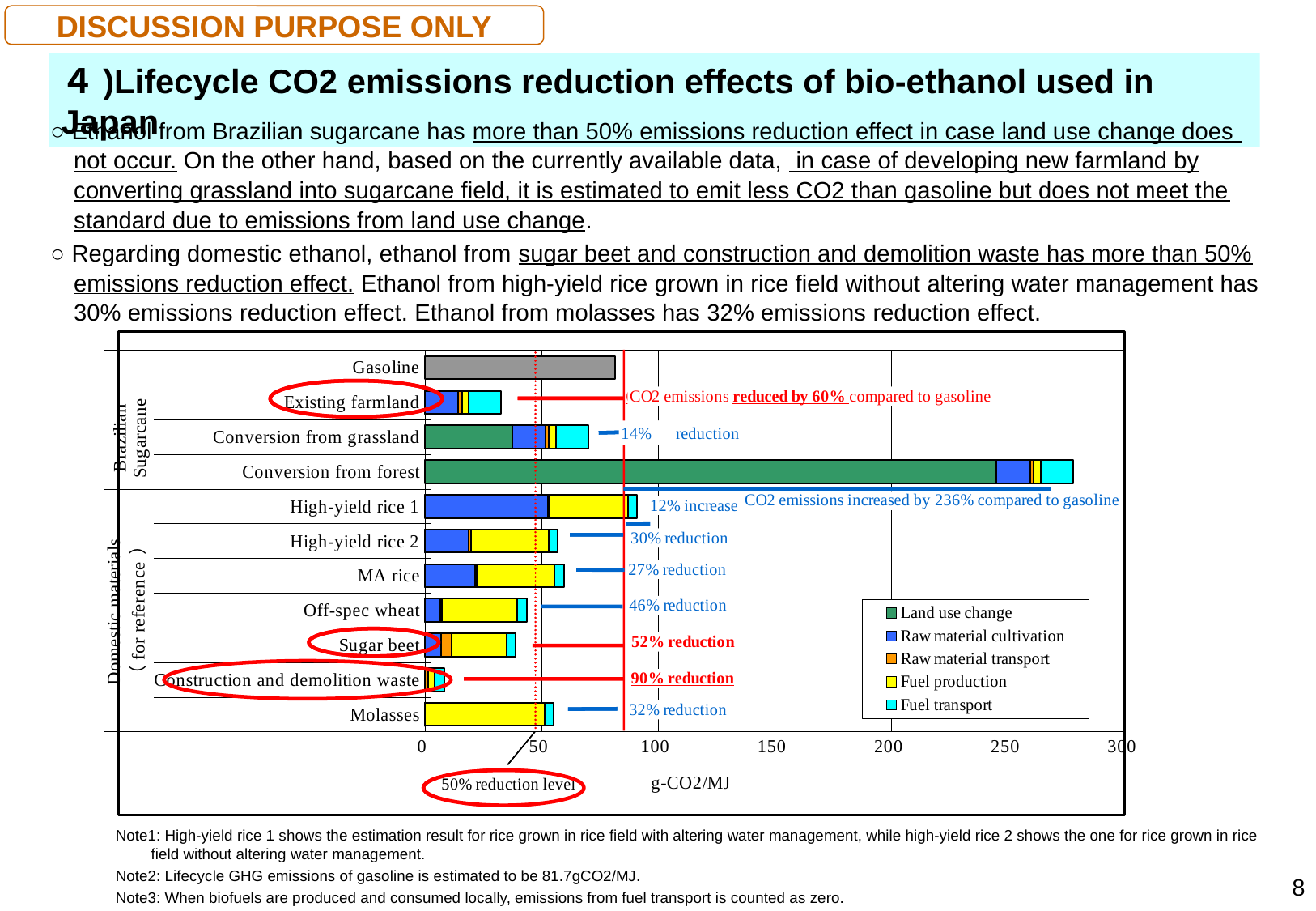
How many categories (bars) are plotted in the chart? 11 Is the total value for Conversion from forest greater or less than 250? greater Which category has the lowest total emissions in the chart? Construction and demolition waste Is the total value for Existing farmland greater or less than 50? less Which has a larger total value, Conversion from forest or Gasoline? Conversion from forest Which category has the highest total emissions in the chart? Conversion from forest How many series does the chart legend list? 5 Is the total value for Gasoline greater or less than 100? less What kind of chart is shown on the slide? bar chart Which has a larger total value, High-yield rice 1 or Sugar beet? High-yield rice 1 What unit is shown on the x axis of the chart? g-CO2/MJ